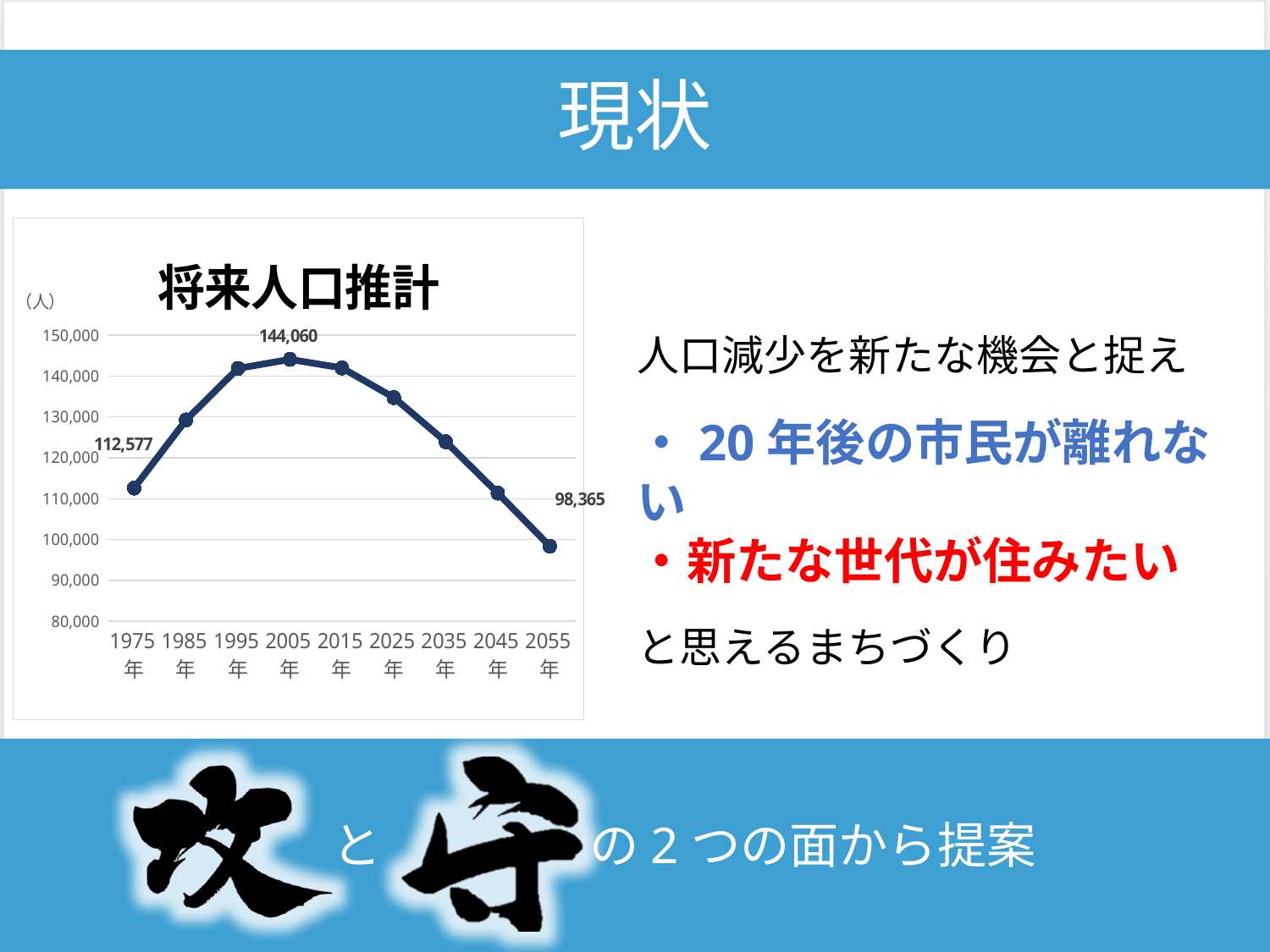
What type of chart is shown on the slide? line chart What is the population value labelled for 2055年? 98,365 Which is larger, the population in 1975年 or in 2055年? 1975年 Which year has the highest population on the chart? 2005年 What is the population value labelled for 2005年? 144,060 What is the title of the chart? 将来人口推計 What is the population value labelled for 1975年? 112,577 How many years are plotted on the x axis? 9 Is the value for 2035年 greater or less than 120,000? greater What is the difference between the population in 2005年 and in 2055年? 45,695 What is the difference between the population in 2005年 and in 1975年? 31,483 Which year has the lowest population on the chart? 2055年